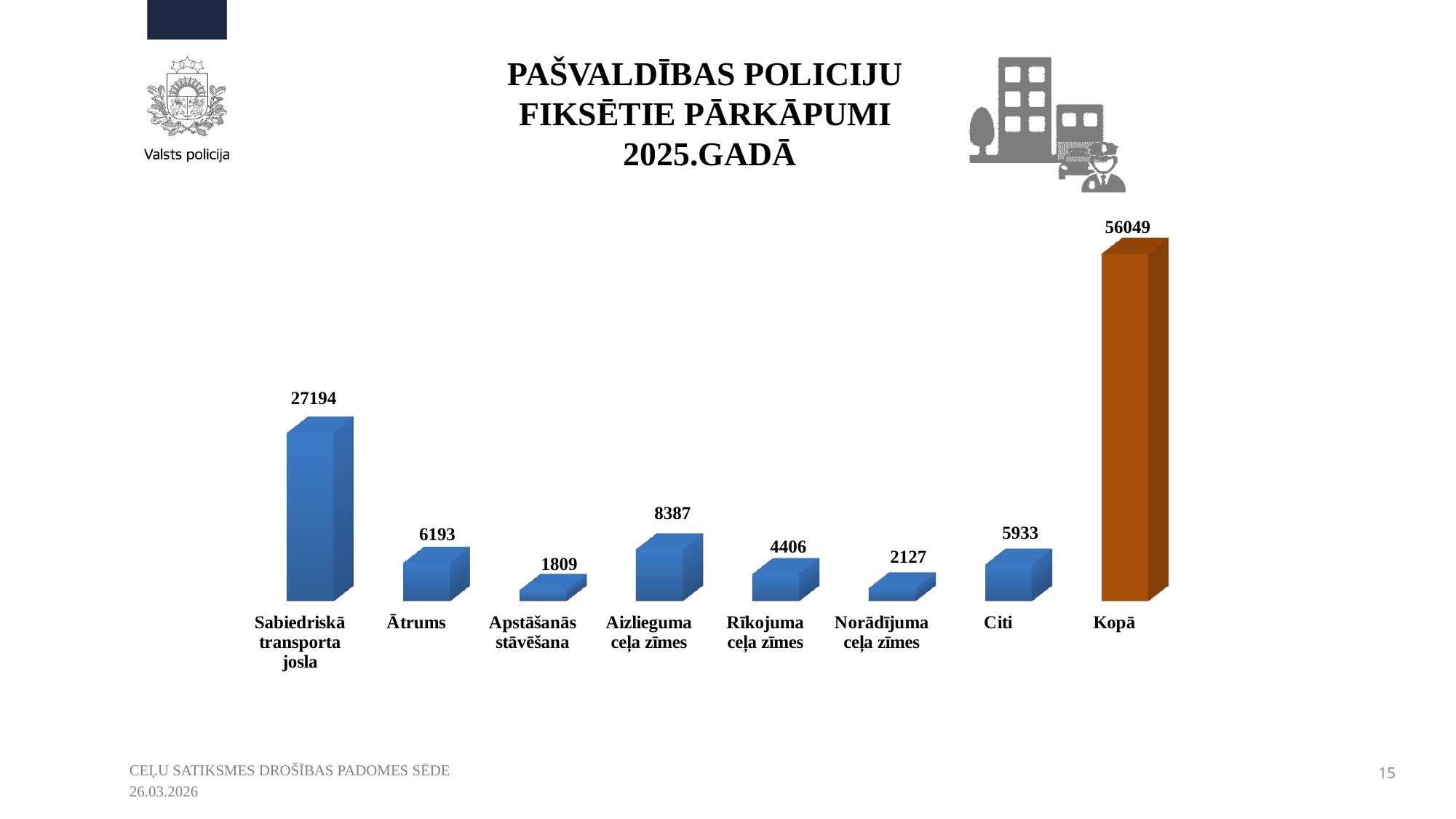
What is the value for Ātrums? 6193 What is the value for Aizlieguma ceļa zīmes? 8387 Excluding the Kopā total bar, which category has the highest value? Sabiedriskā transporta josla What is the value for Sabiedriskā transporta josla? 27194 How many bars are shown in the chart? 8 What colour is the Kopā bar? Orange What is the difference between the values for Aizlieguma ceļa zīmes and Rīkojuma ceļa zīmes? 3981 Which is larger, the value for Norādījuma ceļa zīmes or the value for Rīkojuma ceļa zīmes? Rīkojuma ceļa zīmes What is the value shown for Kopā? 56049 What is the difference between the values for Ātrums and Citi? 260 What type of chart is shown on the slide? Bar chart Which category has the lowest value? Apstāšanās stāvēšana